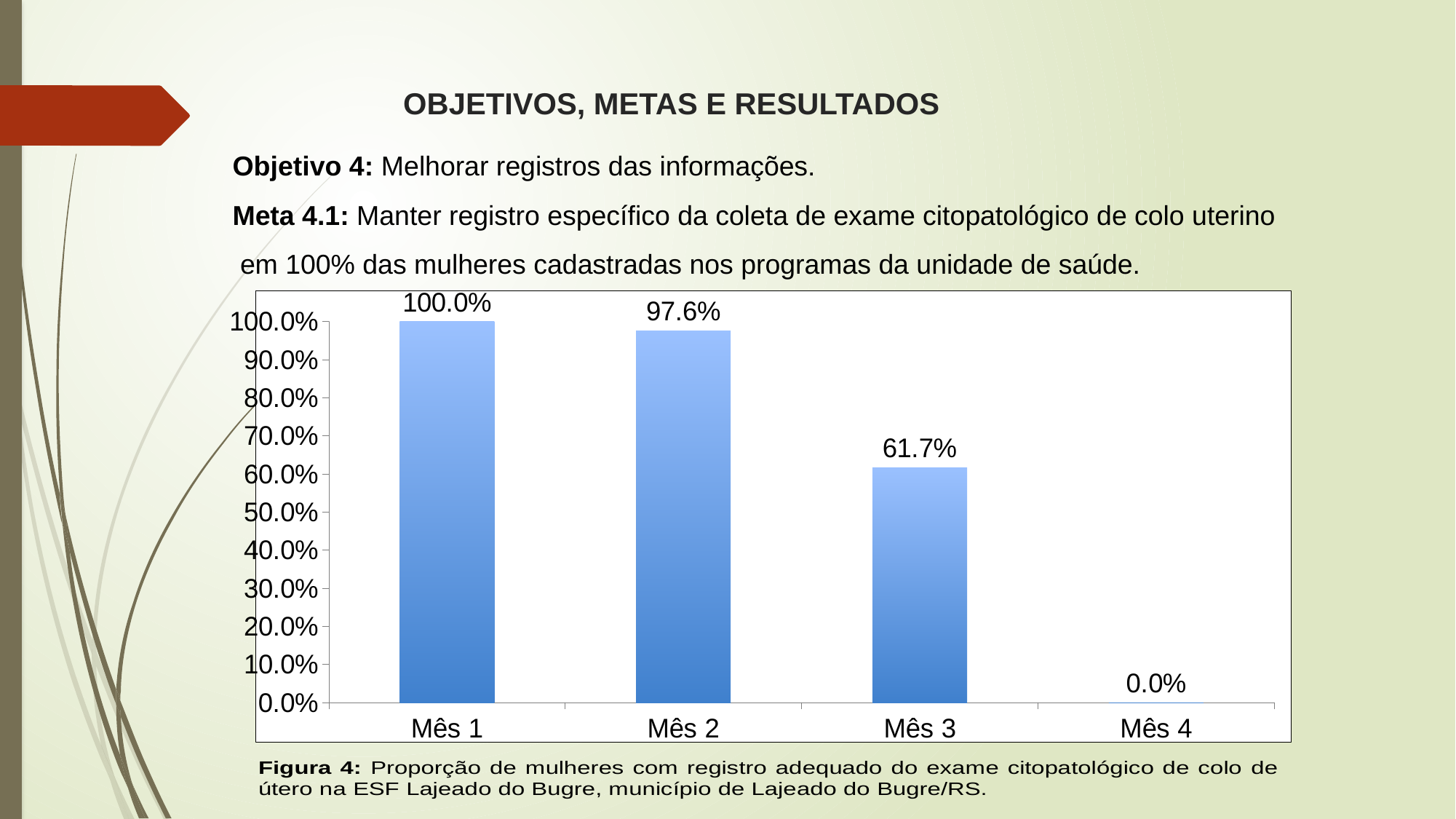
What is the value for Mês 4? 0.0% What is the difference between the values for Mês 1 and Mês 2? 2.4% What is the value for Mês 3? 61.7% What is the value for Mês 1? 100.0% Do the values rise or fall from Mês 1 to Mês 4? Fall What is the value for Mês 2? 97.6% How many months are shown on the x axis? 4 What is the difference between the values for Mês 2 and Mês 3? 35.9% What kind of chart is shown on the slide? Bar chart Which month has the lowest value? Mês 4 Which month has the highest value? Mês 1 Which is larger, the value for Mês 2 or the value for Mês 3? Mês 2